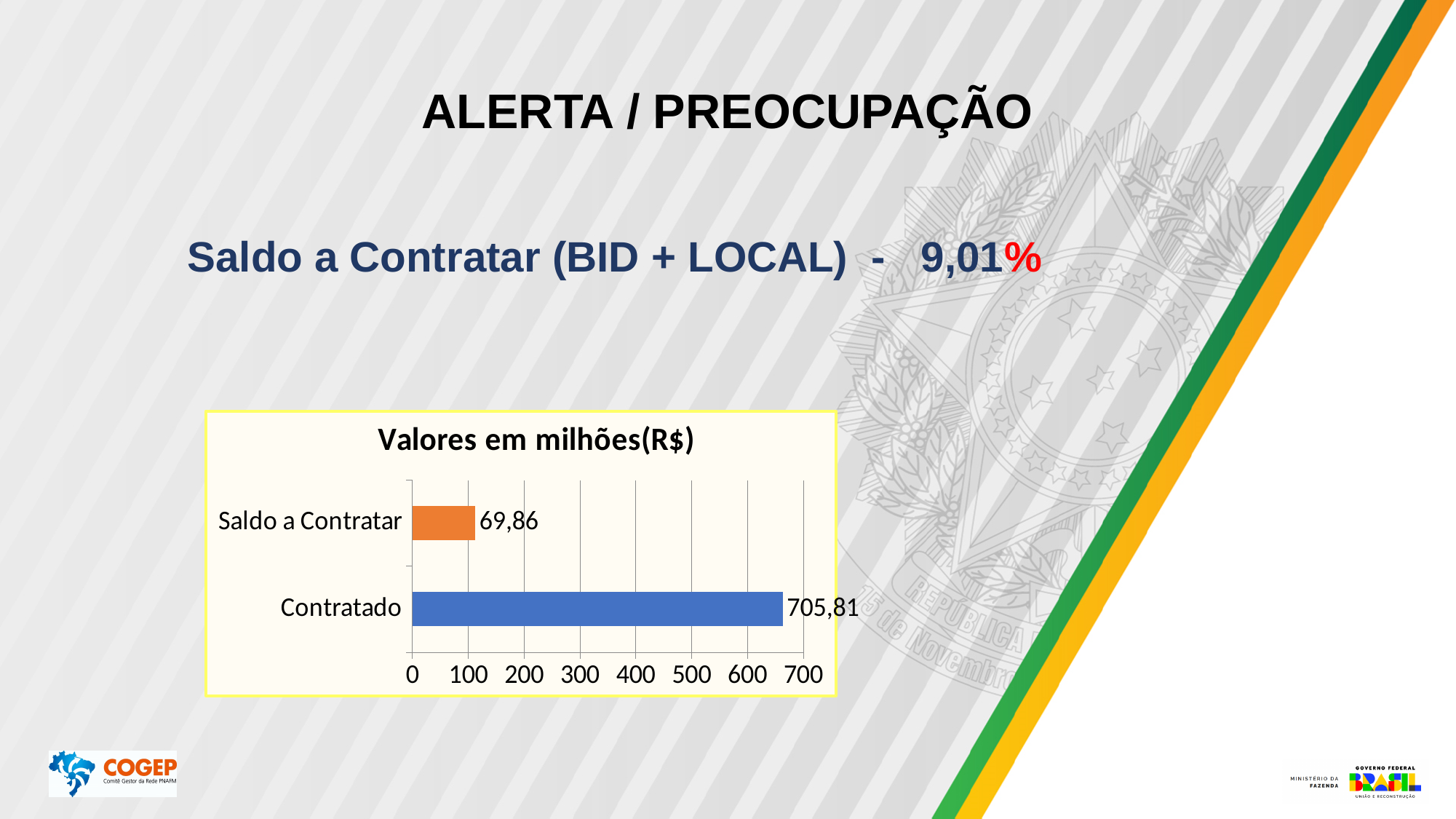
Is the value for Contratado greater or less than 600? greater What colour is the bar for Saldo a Contratar? orange What kind of chart is shown on the slide? bar chart Which is larger, the value for Contratado or the value for Saldo a Contratar? Contratado Which category has the highest value? Contratado What is the value for Contratado? 705,81 What is the title of the chart? Valores em milhões(R$) What is the difference between the values for Contratado and Saldo a Contratar? 635,95 How many categories are shown in the chart? 2 Which category has the lowest value? Saldo a Contratar What is the value for Saldo a Contratar? 69,86